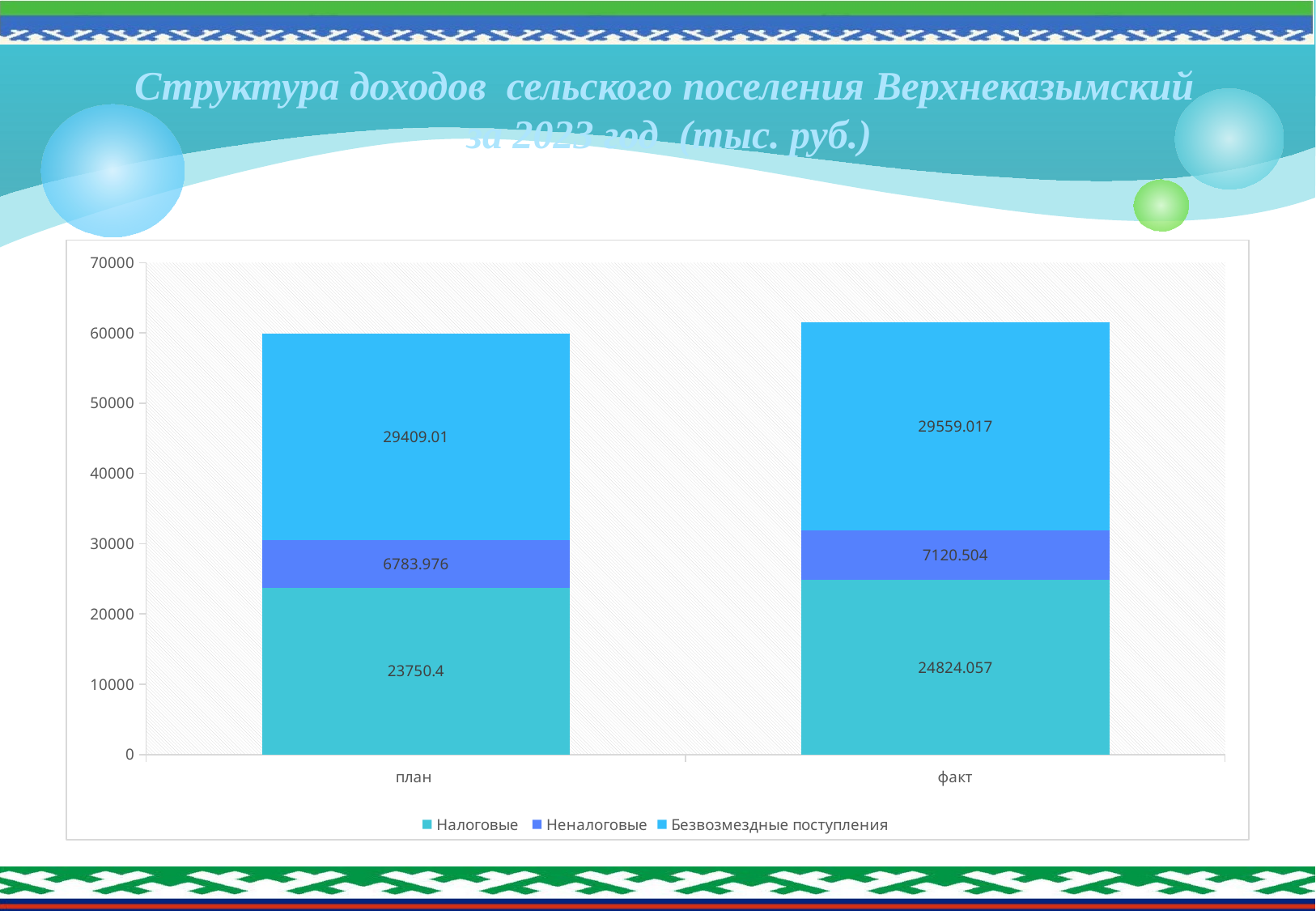
How many series does the legend list? 3 What is the value of Налоговые for план? 23750.4 Which series has the largest value in the факт bar? Безвозмездные поступления What is the value of Неналоговые for факт? 7120.504 What kind of chart is shown on the slide? Stacked bar chart What is the value of Неналоговые for план? 6783.976 What is the total of the факт stacked bar? 61503.578 Which is larger, Неналоговые for план or Неналоговые for факт? факт What is the value of Безвозмездные поступления for факт? 29559.017 Which series has the smallest value in the план bar? Неналоговые What is the total of the план stacked bar? 59943.386 What is the difference between the Налоговые values for факт and план? 1073.657